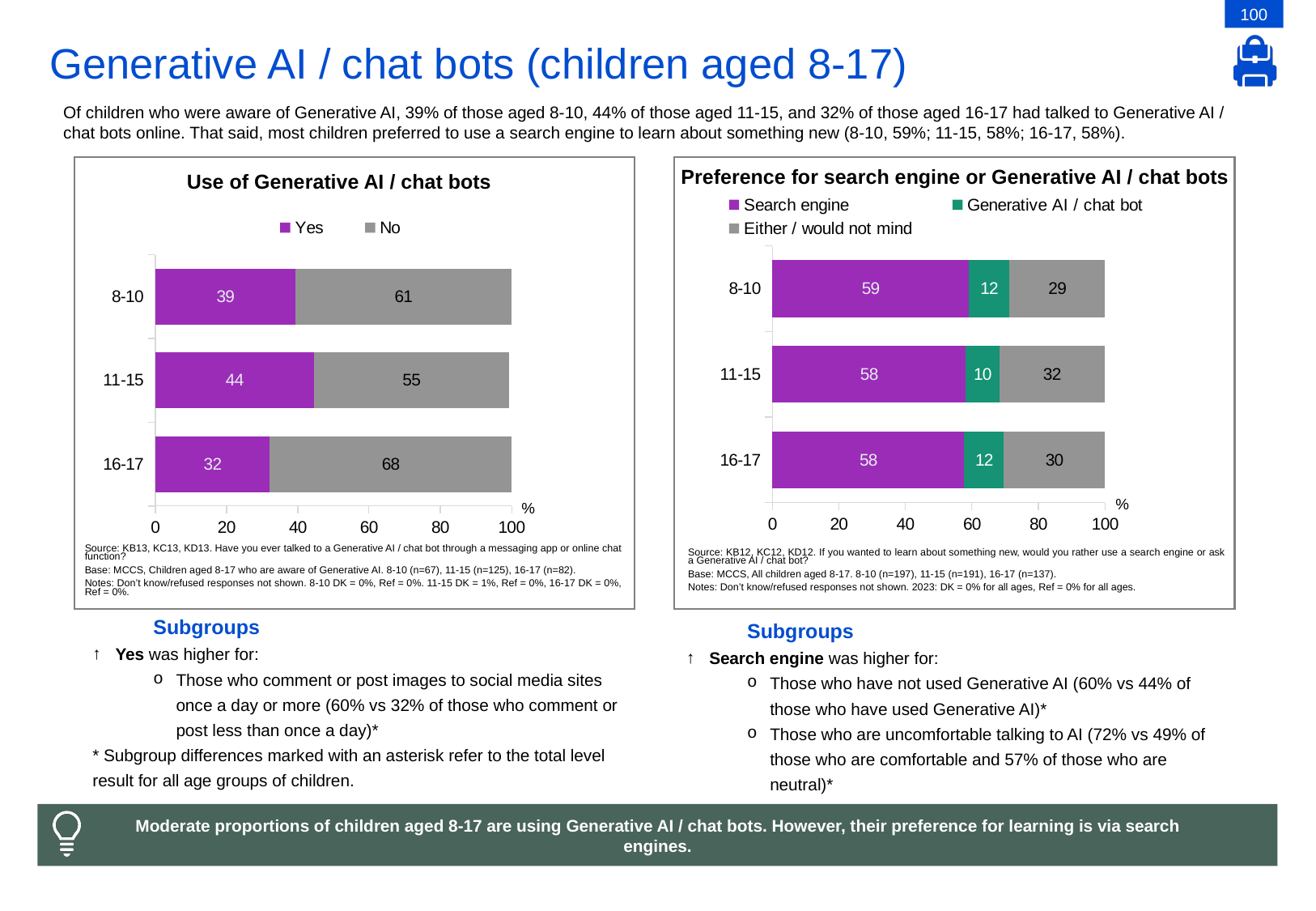
In the 'Preference for search engine or Generative AI / chat bots' chart, is the 'Search engine' value for 16-17 larger or smaller than the 'Either / would not mind' value for 16-17? larger What type of chart is the 'Use of Generative AI / chat bots' chart? Stacked bar chart In the 'Preference for search engine or Generative AI / chat bots' chart, how many series does the legend list? 3 In the 'Use of Generative AI / chat bots' chart, what is the 'Yes' value for children aged 11-15? 44 In the 'Use of Generative AI / chat bots' chart, which age group has the highest 'Yes' value? 11-15 In the 'Use of Generative AI / chat bots' chart, how many series does the legend list? 2 In the 'Preference for search engine or Generative AI / chat bots' chart, what is the 'Either / would not mind' value for children aged 11-15? 32 In the 'Use of Generative AI / chat bots' chart, which age group has the lowest 'Yes' value? 16-17 In the 'Use of Generative AI / chat bots' chart, what is the difference between the 'No' and 'Yes' values for children aged 8-10? 22 In the 'Preference for search engine or Generative AI / chat bots' chart, which age group has the lowest 'Generative AI / chat bot' value? 11-15 In the 'Preference for search engine or Generative AI / chat bots' chart, what is the 'Search engine' value for children aged 8-10? 59 In the 'Use of Generative AI / chat bots' chart, what is the 'No' value for children aged 16-17? 68